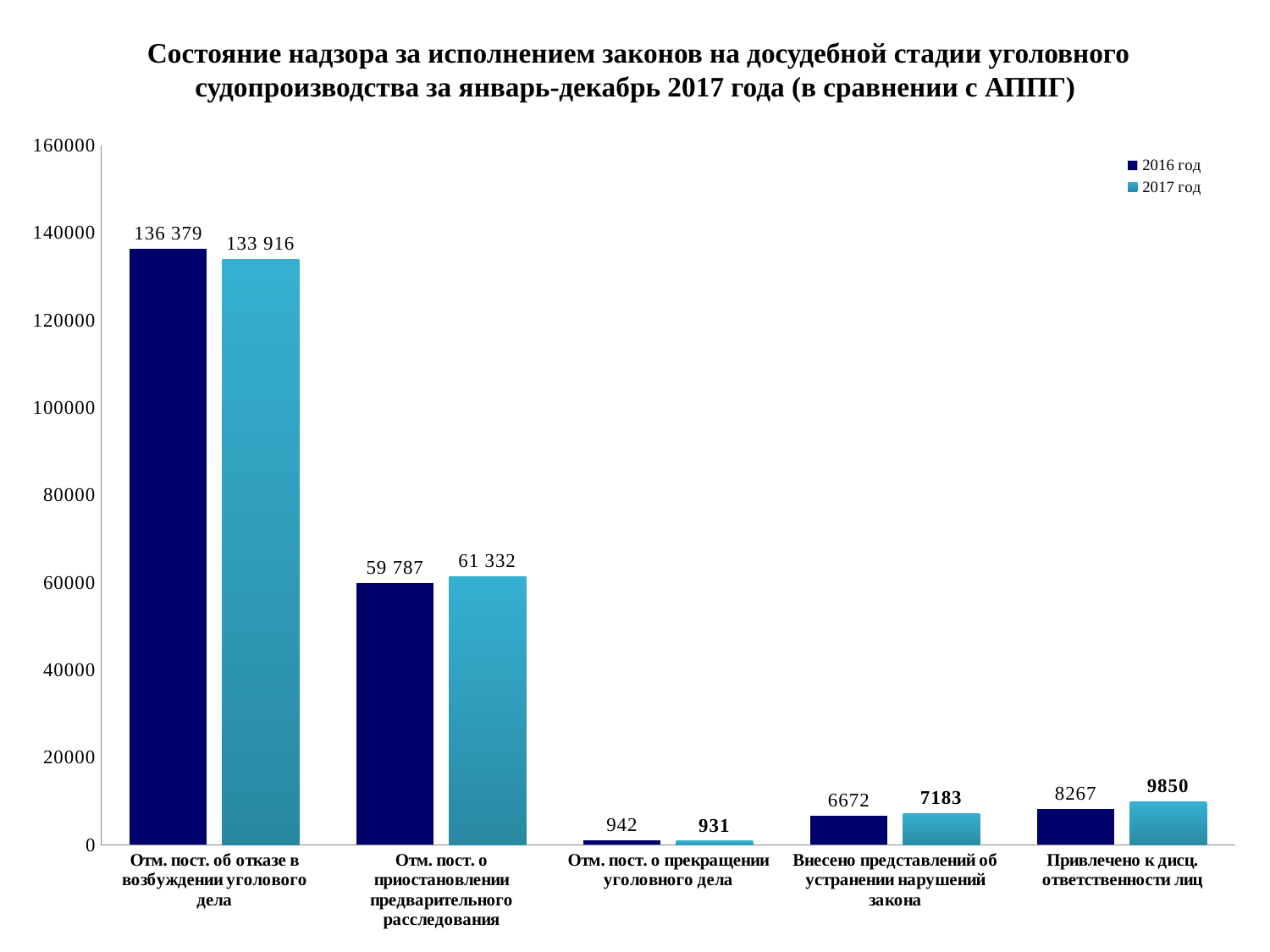
Which category has the lowest value for 2017 год? Отм. пост. о прекращении уголовного дела What is the difference between the 2016 год and 2017 год values for "Отм. пост. об отказе в возбуждении уголовного дела"? 2 463 What is the value for 2017 год for "Отм. пост. о приостановлении предварительного расследования"? 61 332 What is the difference between the 2017 год and 2016 год values for "Привлечено к дисц. ответственности лиц"? 1583 What is the value for 2016 год for "Внесено представлений об устранении нарушений закона"? 6672 What kind of chart is shown on the slide? Bar chart What is the value for 2017 год for "Привлечено к дисц. ответственности лиц"? 9850 For "Внесено представлений об устранении нарушений закона", which year has the larger value, 2016 год or 2017 год? 2017 год Which category has the highest value for 2016 год? Отм. пост. об отказе в возбуждении уголовного дела How many series does the legend list? 2 How many categories are shown on the x axis? 5 What is the value for 2016 год for "Отм. пост. об отказе в возбуждении уголовного дела"? 136 379